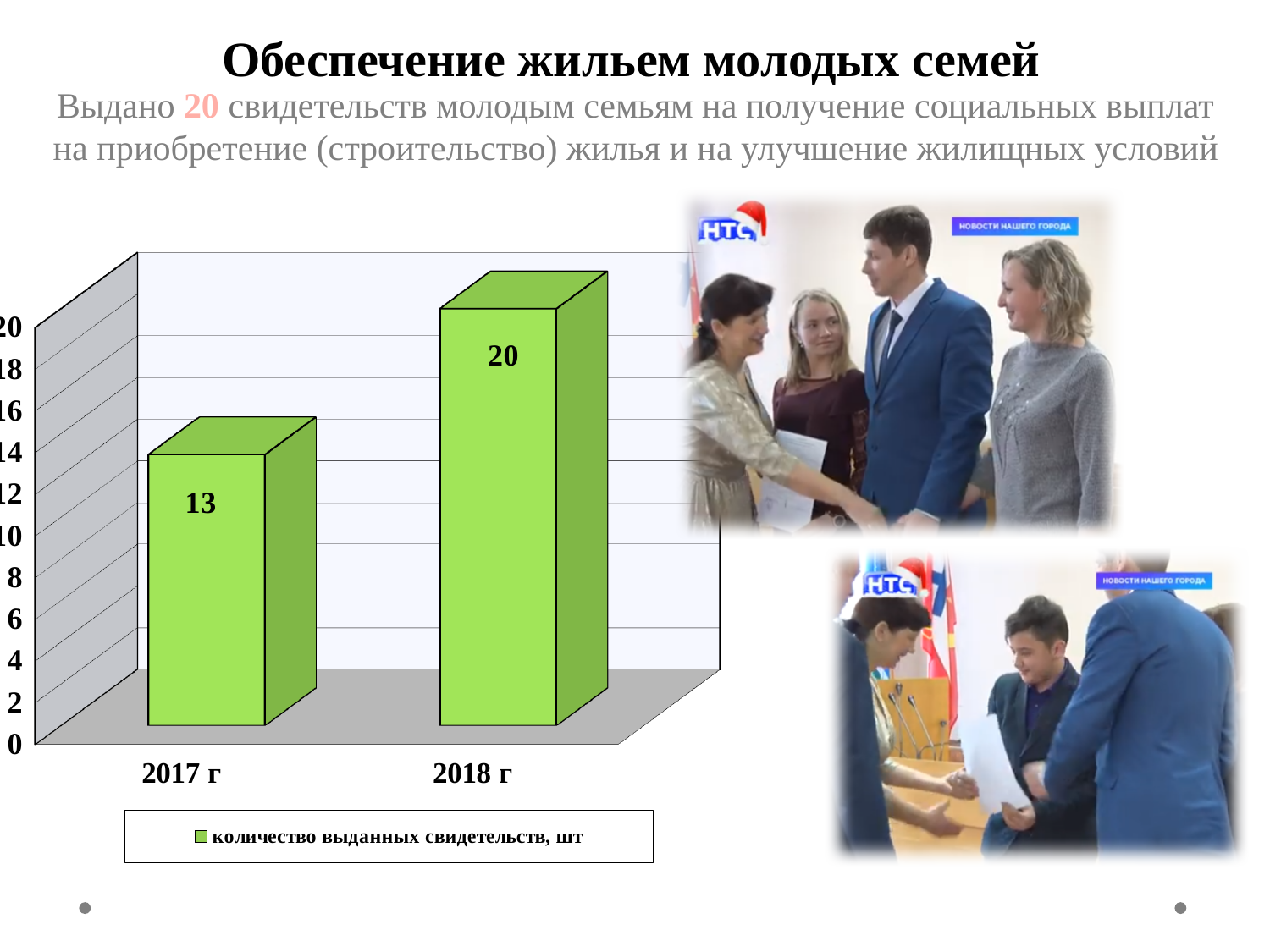
What kind of chart is shown on the slide? bar chart What is the value for 2018 г? 20 What is the difference between the values for 2018 г and 2017 г? 7 What is the legend entry for the series? количество выданных свидетельств, шт Do the values rise or fall from 2017 г to 2018 г? rise Which is larger, the value for 2017 г or the value for 2018 г? 2018 г How many categories are shown on the x axis? 2 What is the value for 2017 г? 13 How many series does the legend list? 1 Is the value for 2017 г greater or less than 10? greater Which year has the highest value? 2018 г Which year has the lowest value? 2017 г